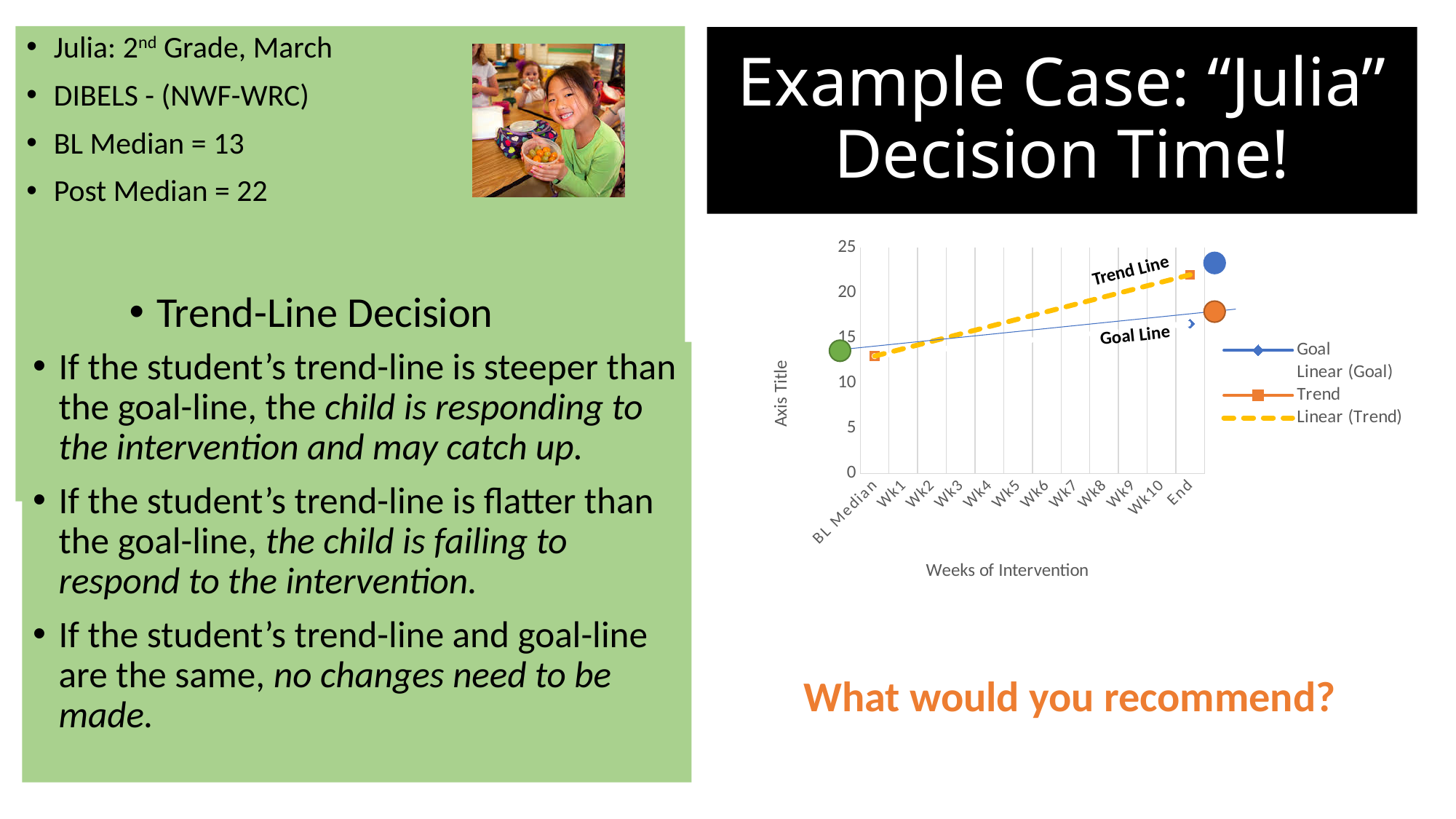
How many categories are shown on the x axis of the chart? 12 What is the title of the x axis of the chart? Weeks of Intervention What kind of chart is shown on the slide? line chart Is the value of the Trend series at End greater or less than 20? greater How many entries does the chart legend list? 4 What is the first category on the x axis of the chart? BL Median Is the value of the Goal series at End greater or less than 20? less Is the value of the Trend series at BL Median greater or less than 15? less At End, which is higher: the Trend series or the Goal series? Trend What is the highest value shown on the y axis of the chart? 25 Does the Trend series rise or fall from BL Median to End? rise Which line is steeper in the chart, the Trend Line or the Goal Line? Trend Line